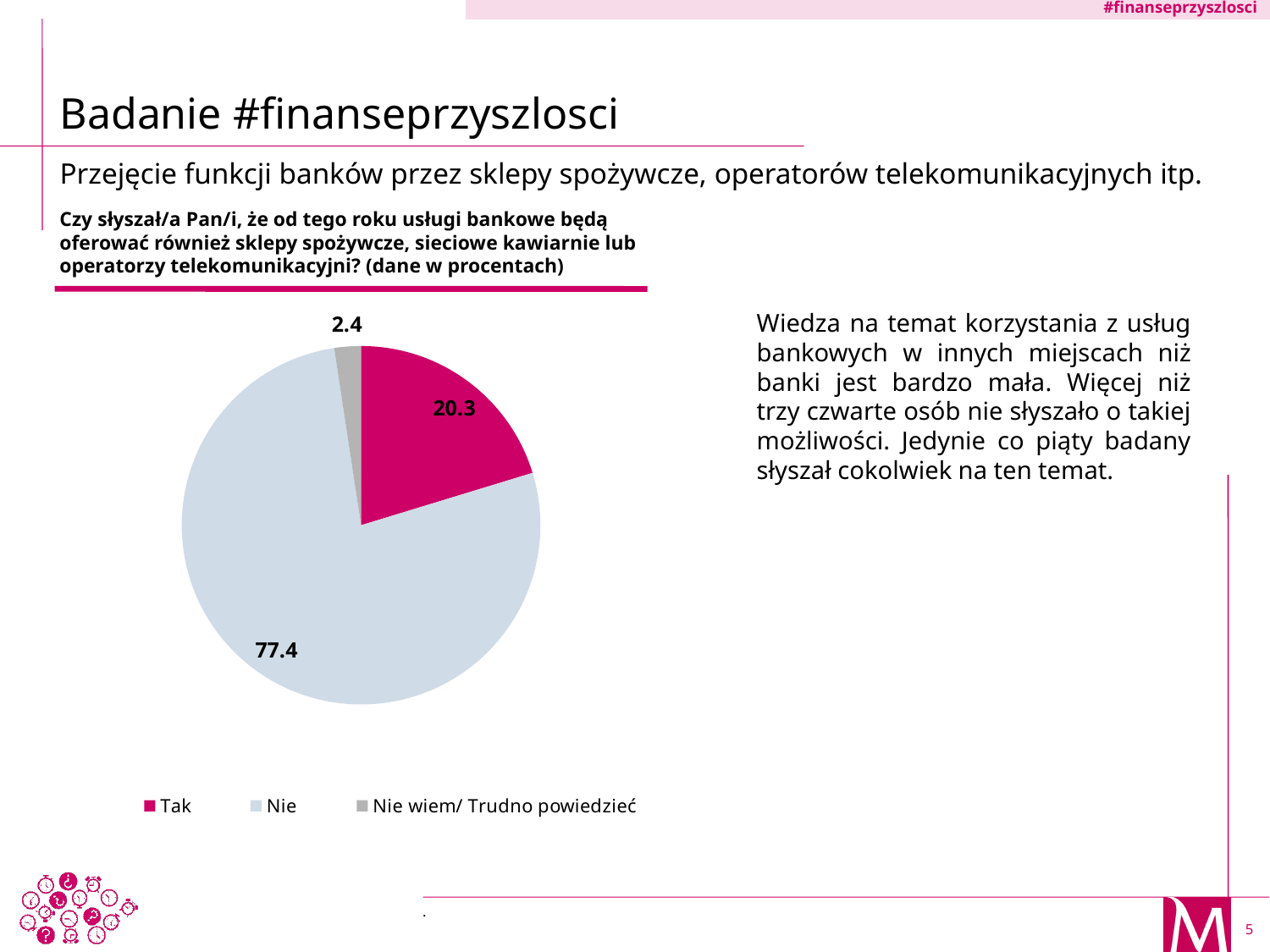
What is the value for "Nie" in the pie chart? 77.4 Which category has the smallest slice of the pie? Nie wiem/ Trudno powiedzieć How many categories does the pie chart have? 3 Which is larger, the value for "Tak" or the value for "Nie wiem/ Trudno powiedzieć"? Tak How many entries does the legend list? 3 What is the total of the three values shown in the pie chart? 100.1 What is the difference between the values for "Nie" and "Tak"? 57.1 Which category has the largest slice of the pie? Nie What is the value for "Nie wiem/ Trudno powiedzieć" in the pie chart? 2.4 What colour is the "Tak" slice in the pie chart? magenta (pink) What kind of chart is shown on the slide? pie chart What is the value for "Tak" in the pie chart? 20.3